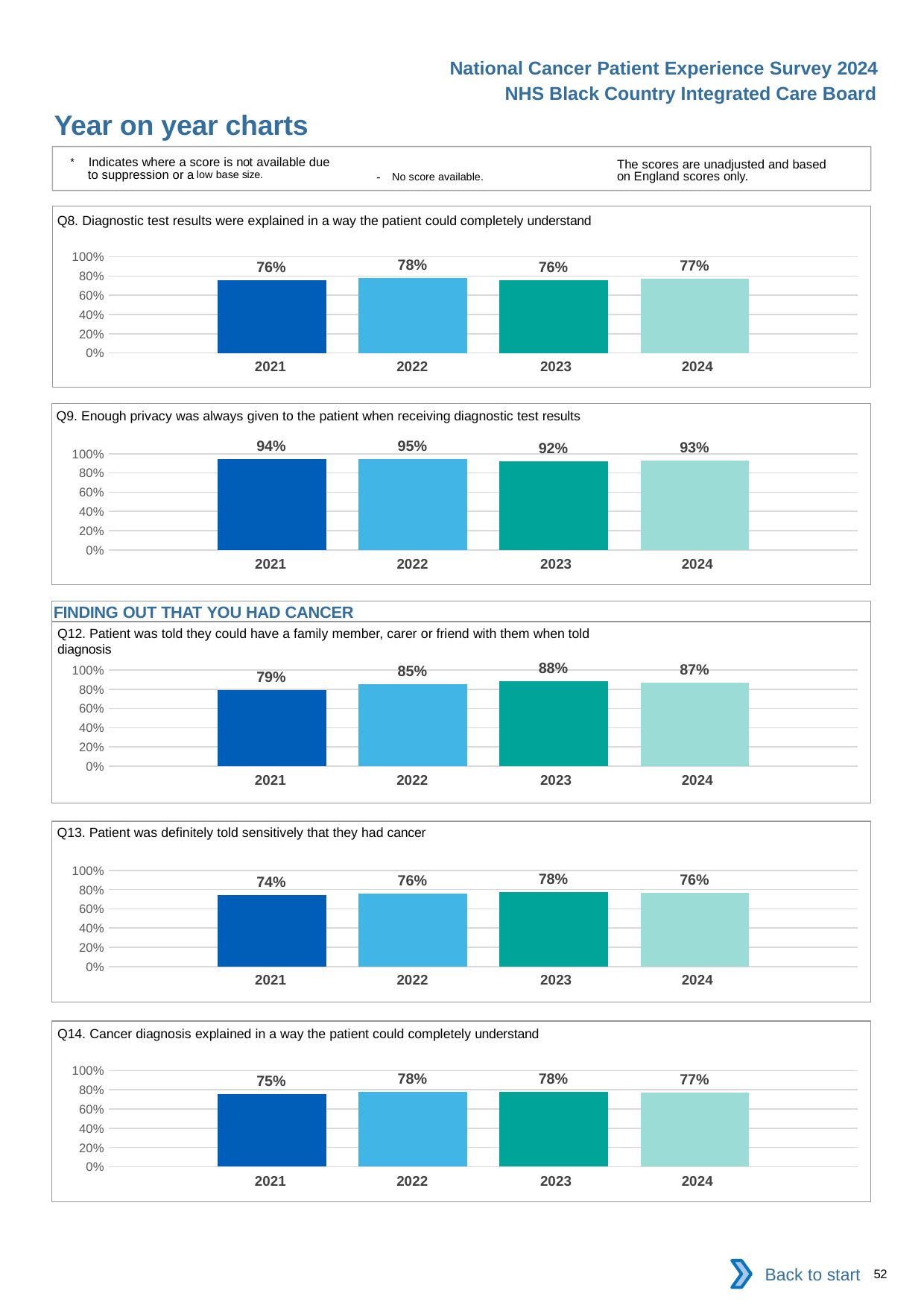
In the Q8 chart (Diagnostic test results were explained in a way the patient could completely understand), what is the value for 2022? 78% In the Q14 chart (Cancer diagnosis explained in a way the patient could completely understand), what is the value for 2021? 75% In the Q12 chart (Patient was told they could have a family member, carer or friend with them when told diagnosis), what is the value for 2024? 87% In the Q8 chart (Diagnostic test results were explained in a way the patient could completely understand), what is the difference between the 2022 and 2023 values? 2 percentage points In the Q9 chart (Enough privacy was always given to the patient when receiving diagnostic test results), which year has the highest value? 2022 How many years are shown on the x axis of the Q8 chart? 4 In the Q13 chart (Patient was definitely told sensitively that they had cancer), is the value for 2021 larger or smaller than the value for 2022? smaller In the Q9 chart (Enough privacy was always given to the patient when receiving diagnostic test results), which year has the lowest value? 2023 In the Q13 chart (Patient was definitely told sensitively that they had cancer), which year has the highest value? 2023 What type of chart is the Q9 chart (Enough privacy was always given to the patient when receiving diagnostic test results)? Bar chart In the Q14 chart (Cancer diagnosis explained in a way the patient could completely understand), which year has the lowest value? 2021 In the Q12 chart (Patient was told they could have a family member, carer or friend with them when told diagnosis), what is the difference between the 2023 and 2021 values? 9 percentage points